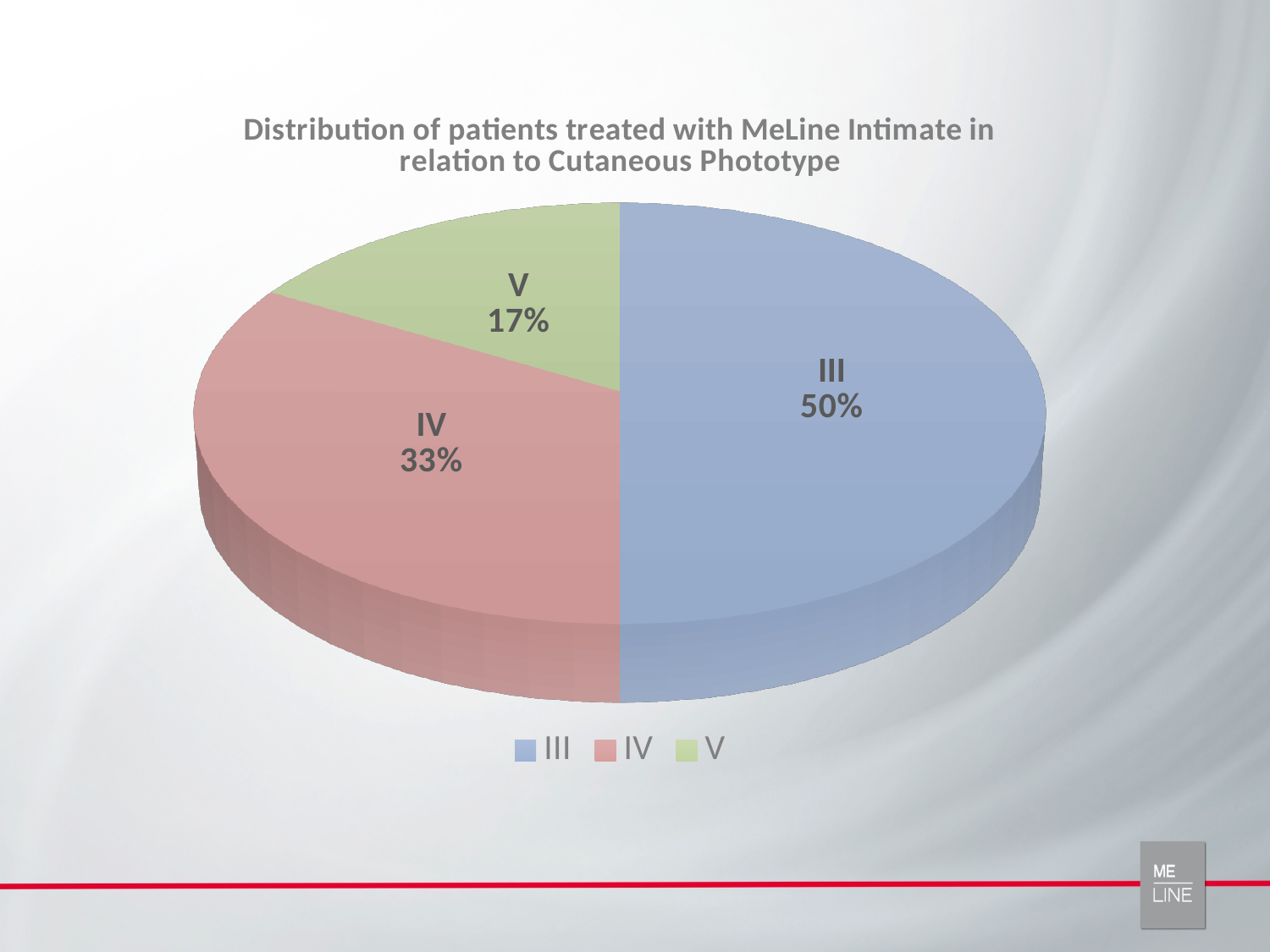
What is the difference in percentage points between the shares for phototype IV and phototype V? 16 How many phototype categories are shown in the pie chart? 3 What share of patients treated with MeLine Intimate have cutaneous phototype III? 50% Which has a larger share of patients, phototype IV or phototype V? IV What share of patients have cutaneous phototype V? 17% What is the difference in percentage points between the shares for phototype III and phototype IV? 17 What kind of chart is shown on the slide? Pie chart Which phototype accounts for the smallest share of patients? V Which phototype accounts for the largest share of patients? III What share of patients have cutaneous phototype IV? 33% Which colour represents phototype IV in the chart? Red (pink) What is the title of the chart? Distribution of patients treated with MeLine Intimate in relation to Cutaneous Phototype